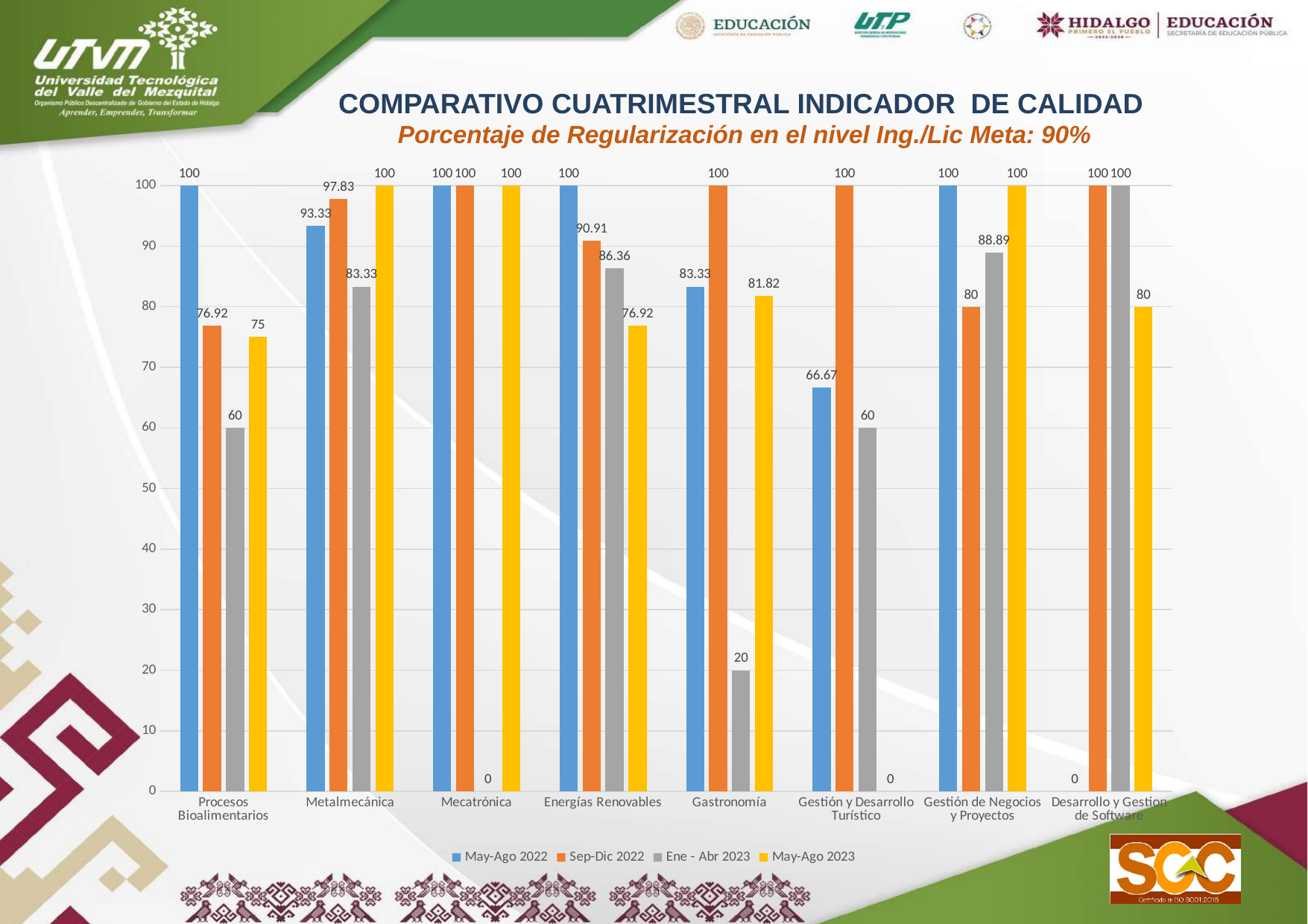
What kind of chart is shown on the slide? Bar chart What is the value for Gastronomía in the May-Ago 2023 series? 81.82 Which category has the lowest value in the Ene - Abr 2023 series? Mecatrónica How many categories are shown on the x axis? 8 Which category has the lowest value in the May-Ago 2022 series? Desarrollo y Gestion de Software Which is larger for Energías Renovables: the Sep-Dic 2022 value or the May-Ago 2023 value? Sep-Dic 2022 How many series does the legend list? 4 What is the value for Metalmecánica in the Ene - Abr 2023 series? 83.33 Is the Ene - Abr 2023 value for Gestión de Negocios y Proyectos greater or less than 80? greater What is the value for Procesos Bioalimentarios in the Sep-Dic 2022 series? 76.92 What is the value for Gestión y Desarrollo Turístico in the May-Ago 2022 series? 66.67 What is the difference between the Sep-Dic 2022 and Ene - Abr 2023 values for Gastronomía? 80